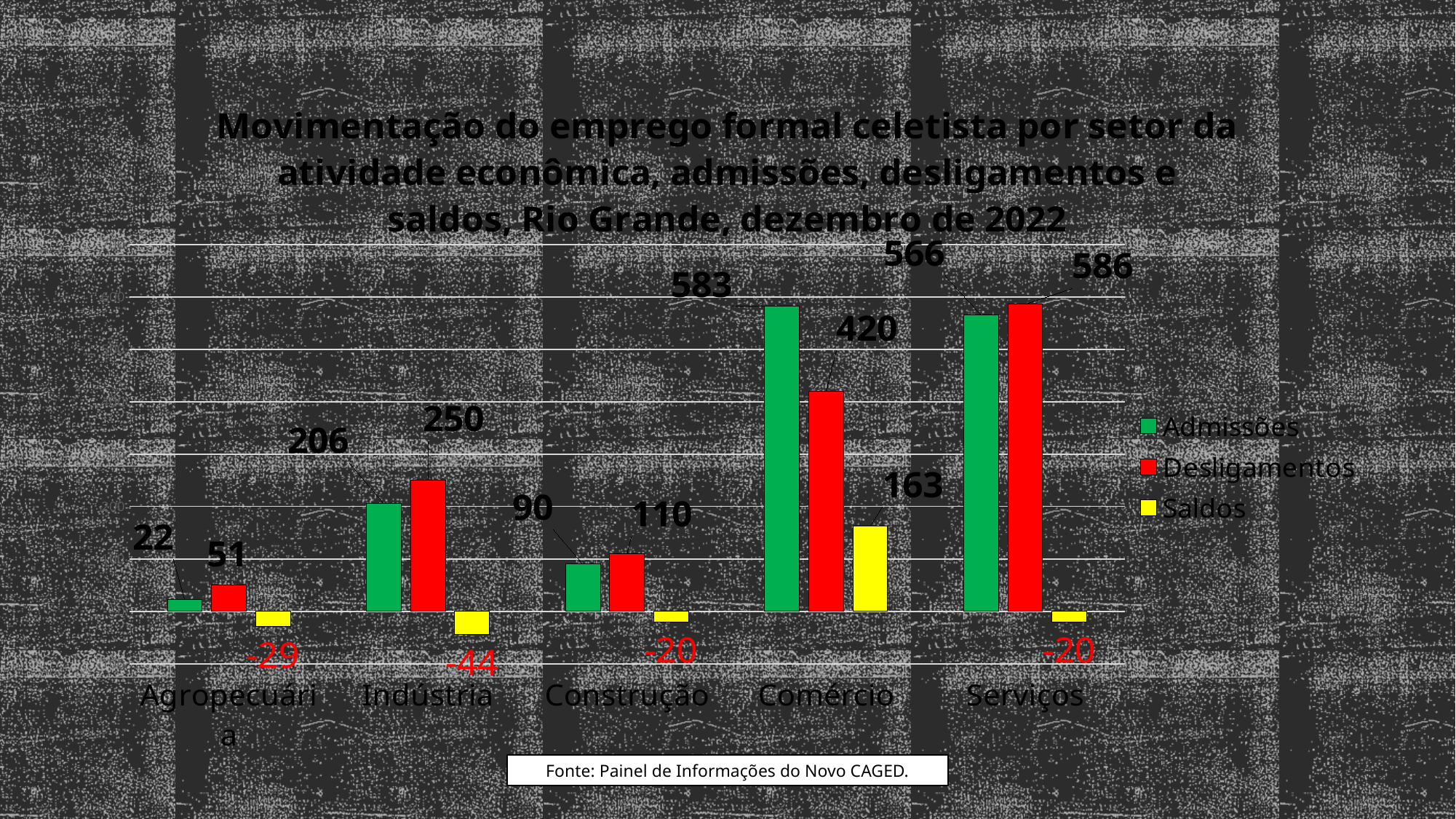
What is the value of Admissões for Agropecuária? 22 What is the difference between Admissões and Desligamentos for Indústria? 44 What is the value of Admissões for Comércio? 583 What is the value of Desligamentos for Serviços? 586 For Comércio, which is larger: Admissões or Desligamentos? Admissões How many series does the legend list? 3 What is the Saldos value for Indústria? -44 How many sectors are shown on the x axis? 5 Which sector is the only one with a positive Saldos value? Comércio What kind of chart is shown on the slide? Bar chart Which sector has the lowest Desligamentos value? Agropecuária Which sector has the highest Admissões value? Comércio